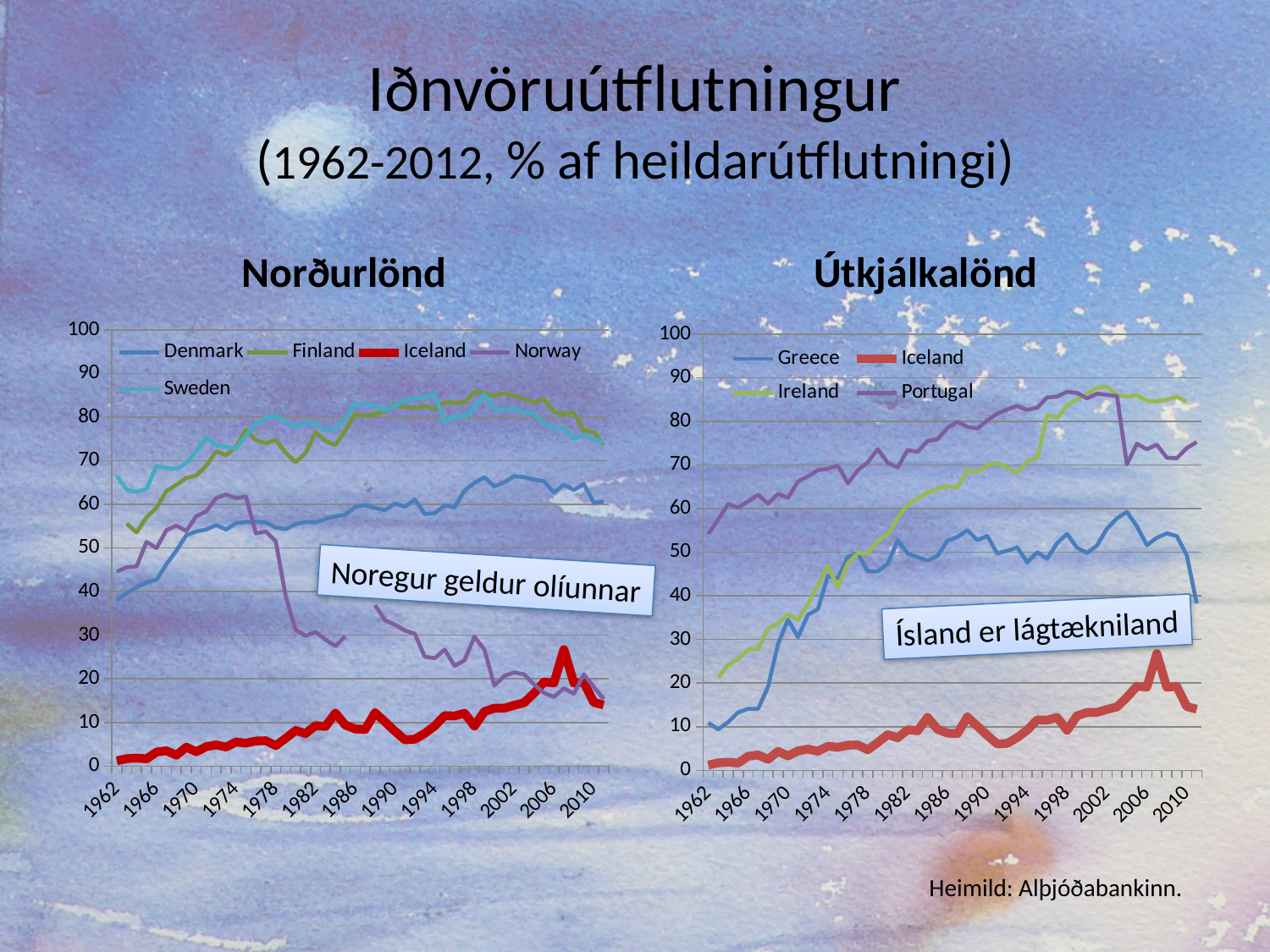
In the Útkjálkalönd chart, which series has the lowest values across the whole period? Iceland In the Útkjálkalönd chart, is the value for Ireland in 2010 greater or less than 80? greater How many series does the legend of the Norðurlönd chart list? 5 How many series does the legend of the Útkjálkalönd chart list? 4 In the Útkjálkalönd chart, does the Ireland series generally rise or fall from 1962 to 2010? rise In the Norðurlönd chart, which is larger in 2010, Denmark or Iceland? Denmark What text does the callout box on the Útkjálkalönd chart show? Ísland er lágtækniland In the Norðurlönd chart, is the value for Norway in 1974 greater or less than 50? greater In the Norðurlönd chart, is the value for Norway in 1990 greater or less than 40? less In the Norðurlönd chart, which series has the lowest values across the whole period? Iceland What kind of chart is the Norðurlönd chart on the left? line chart